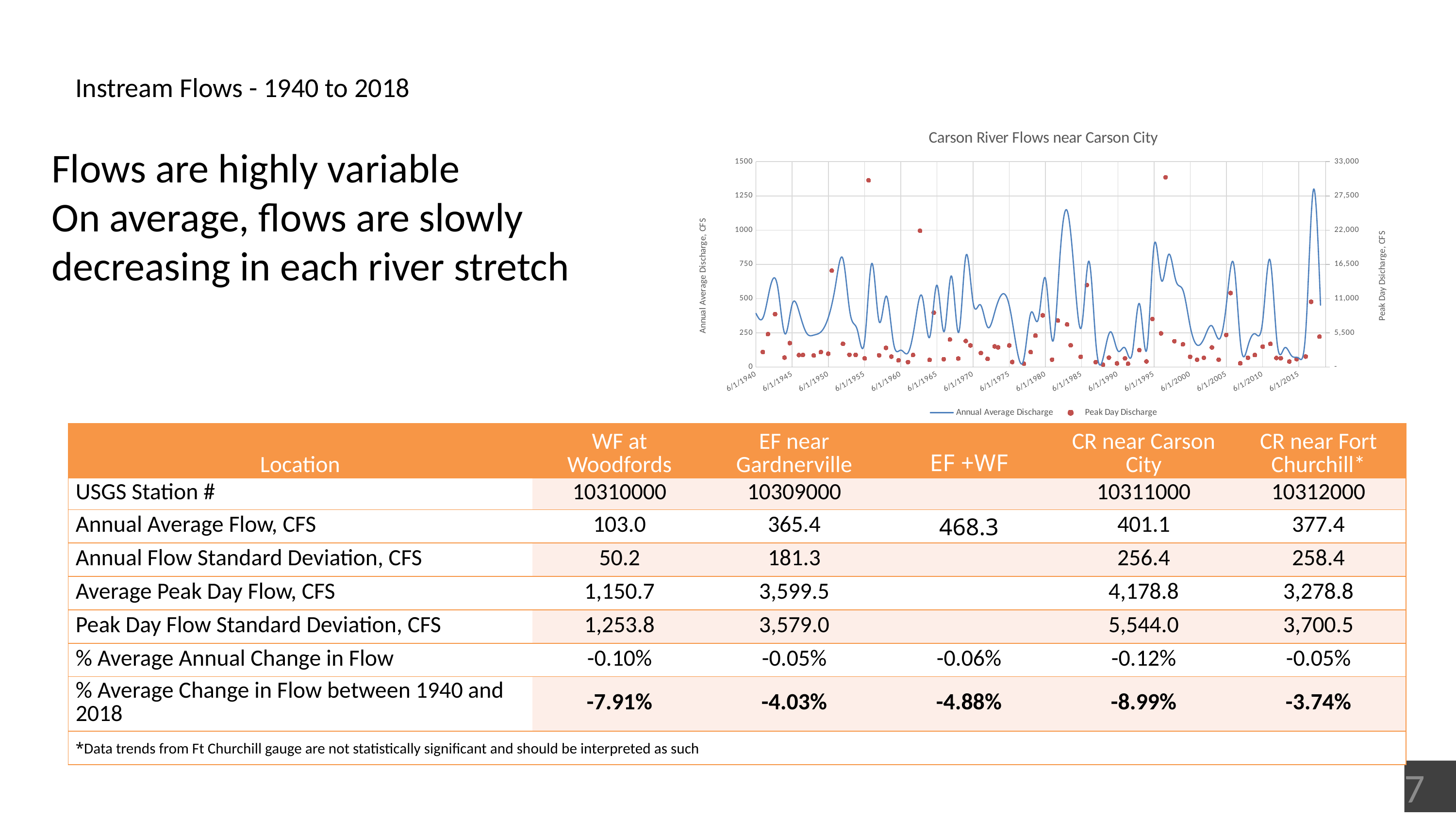
Is the Annual Average Discharge peak around 6/1/1983 greater or less than 1000? greater What kind of chart is used to show the Annual Average Discharge series? line chart How many series does the chart's legend list? 2 Is the Annual Average Discharge value around 6/1/1977 greater or less than 250? less What is the maximum value shown on the left vertical axis of the chart? 1500 Is the highest value of the Annual Average Discharge line (around 2017) greater or less than 1250? greater What is the title of the chart on the slide? Carson River Flows near Carson City What is the maximum value shown on the right vertical axis of the chart? 33,000 What are the two series named in the chart's legend? Annual Average Discharge and Peak Day Discharge